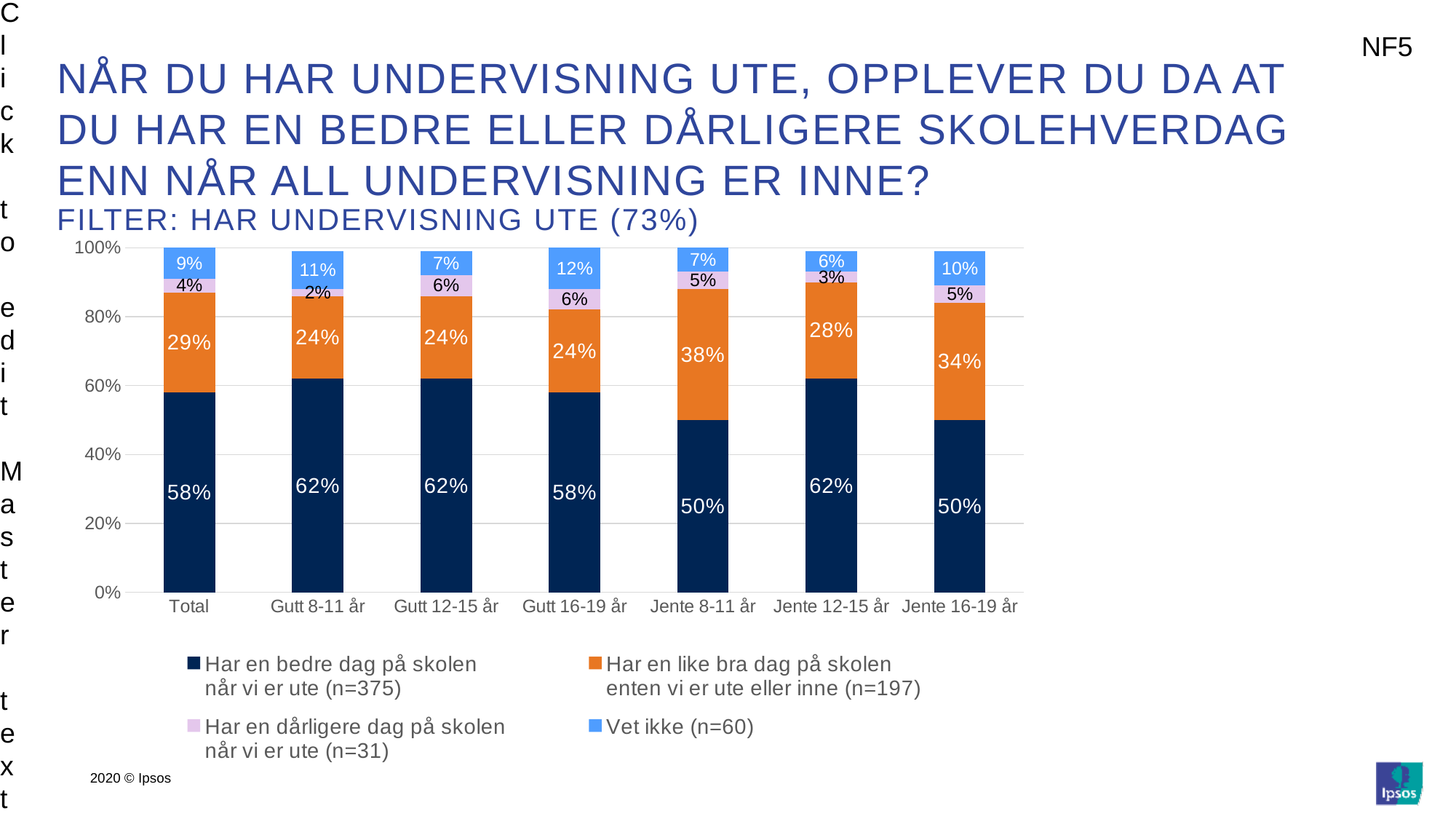
What is the "Vet ikke" value for Gutt 16-19 år? 12% What is the difference between the "Har en like bra dag" value for Jente 8-11 år and for Total? 9 percentage points How many series does the legend list? 4 What is the value for "Har en like bra dag på skolen enten vi er ute eller inne" for Jente 8-11 år? 38% Which is larger: the "Har en bedre dag på skolen når vi er ute" value for Gutt 12-15 år or for Jente 16-19 år? Gutt 12-15 år How many categories are shown on the x axis? 7 Which category has the highest value for "Har en like bra dag på skolen enten vi er ute eller inne"? Jente 8-11 år What is the value for "Har en dårligere dag på skolen når vi er ute" for Gutt 8-11 år? 2% What kind of chart is shown on the slide? Stacked bar chart Which category has the lowest "Vet ikke" value? Jente 12-15 år What is the sample size (n) given in the legend for "Vet ikke"? n=60 What percentage of the Total group say they have a better day at school when outside ("Har en bedre dag på skolen når vi er ute")? 58%